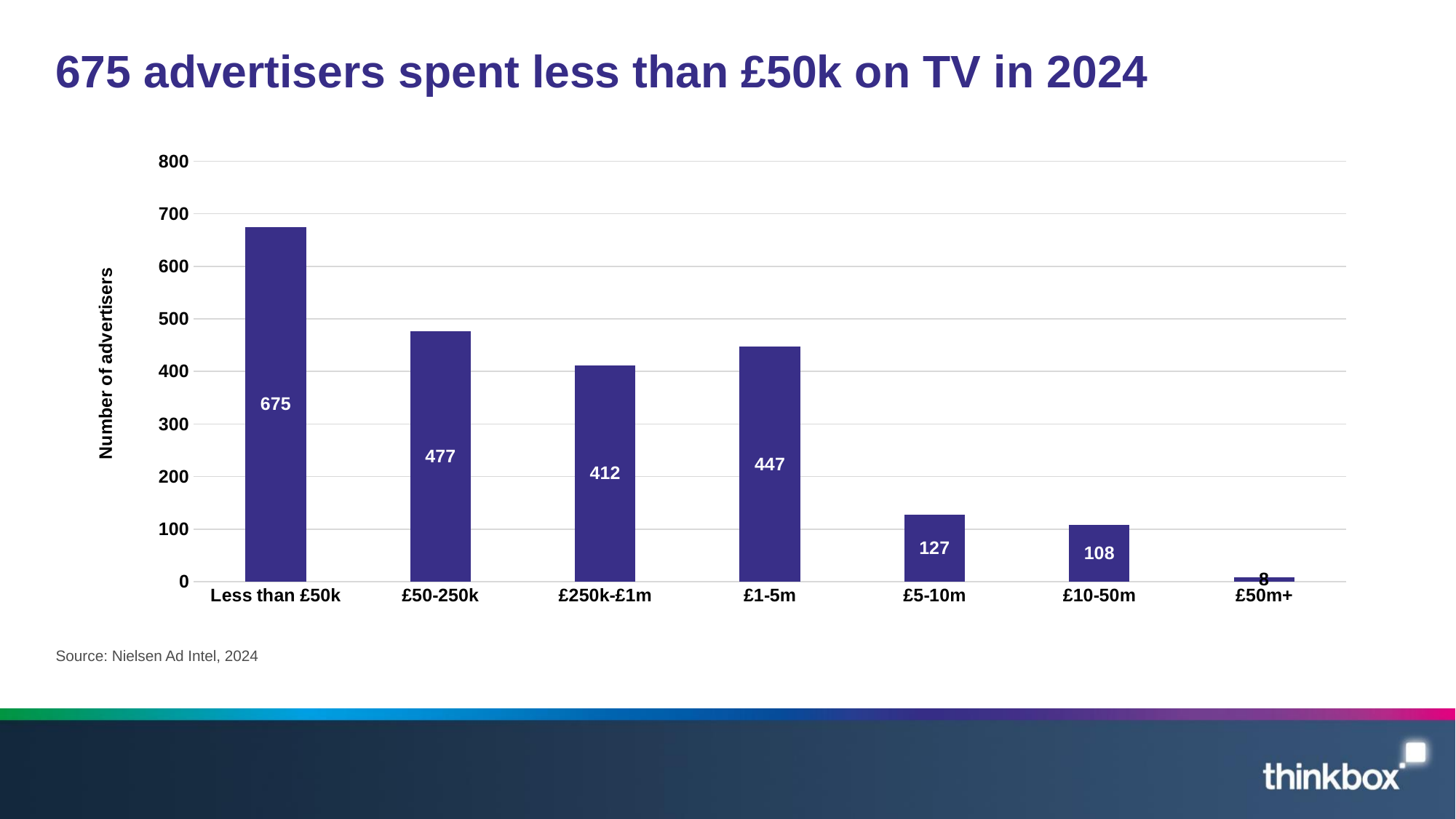
How many advertisers spent less than £50k on TV in 2024? 675 What is the difference in the number of advertisers between the £5-10m band and the £10-50m band? 19 What kind of chart is shown on the slide? Bar chart Which spend band has the lowest number of advertisers? £50m+ What is the label of the vertical axis? Number of advertisers What is the number of advertisers in the £50-250k spend band? 477 What is the number of advertisers in the £50m+ spend band? 8 Which has more advertisers, the £250k-£1m band or the £1-5m band? £1-5m Which spend band has the highest number of advertisers? Less than £50k What is the number of advertisers in the £5-10m spend band? 127 How many spend bands are shown on the chart? 7 What is the difference in the number of advertisers between the £50-250k band and the £250k-£1m band? 65